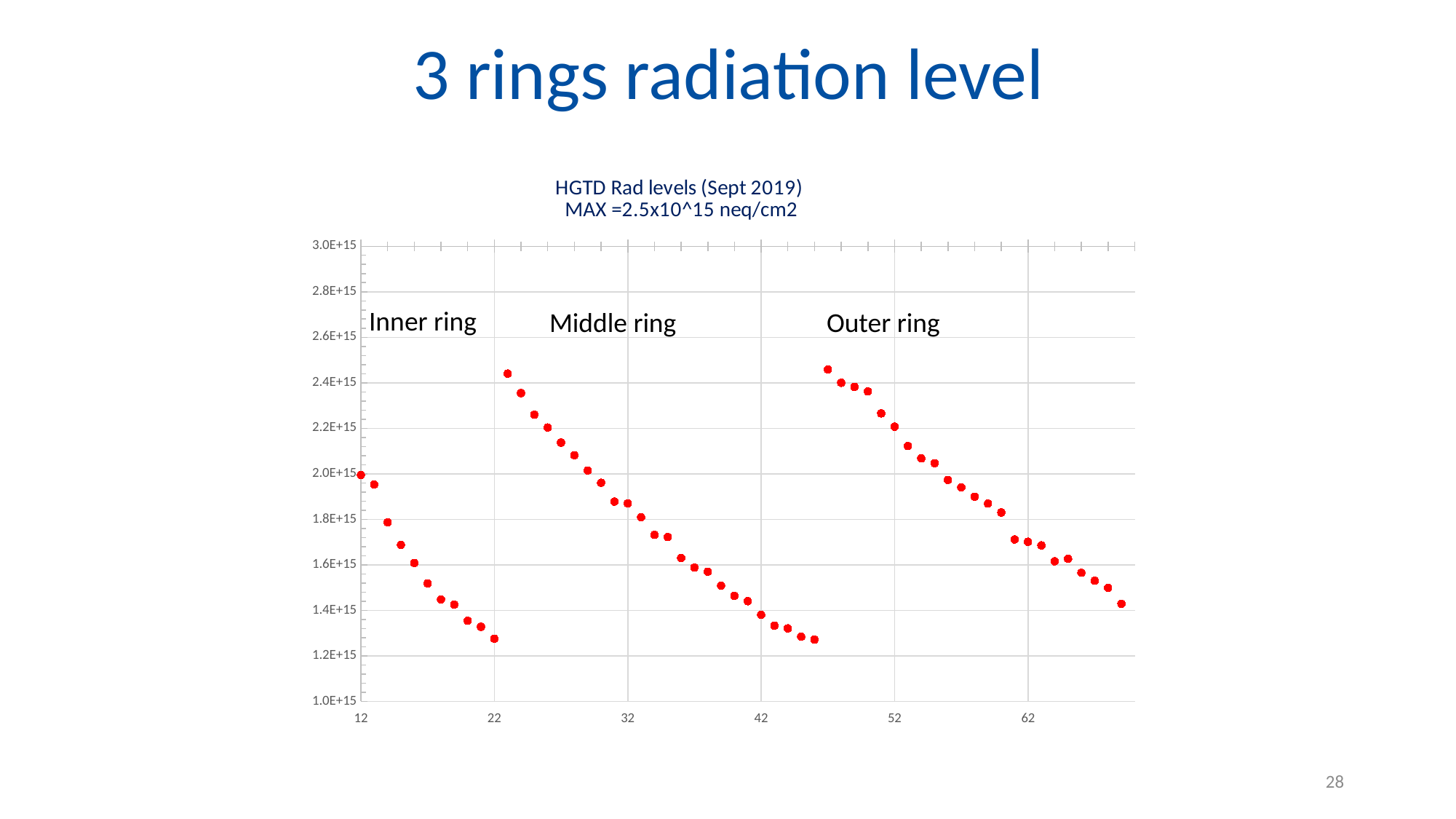
Is the lowest value for the Middle ring greater or less than 1.4E+15? less What is the title of the chart? HGTD Rad levels (Sept 2019) MAX =2.5x10^15 neq/cm2 Which ring has the lower peak value, the Inner ring or the Middle ring? Inner ring Is the highest value for the Middle ring greater or less than 2.6E+15? less What kind of chart is shown on the slide? Scatter chart What colour are the data points on the chart? Red Which ring has the lowest peak value? Inner ring Is the highest value for the Outer ring greater or less than 2.4E+15? greater How many rings are labelled on the chart? 3 Within each ring, do the radiation values rise or fall as the x value increases? Fall